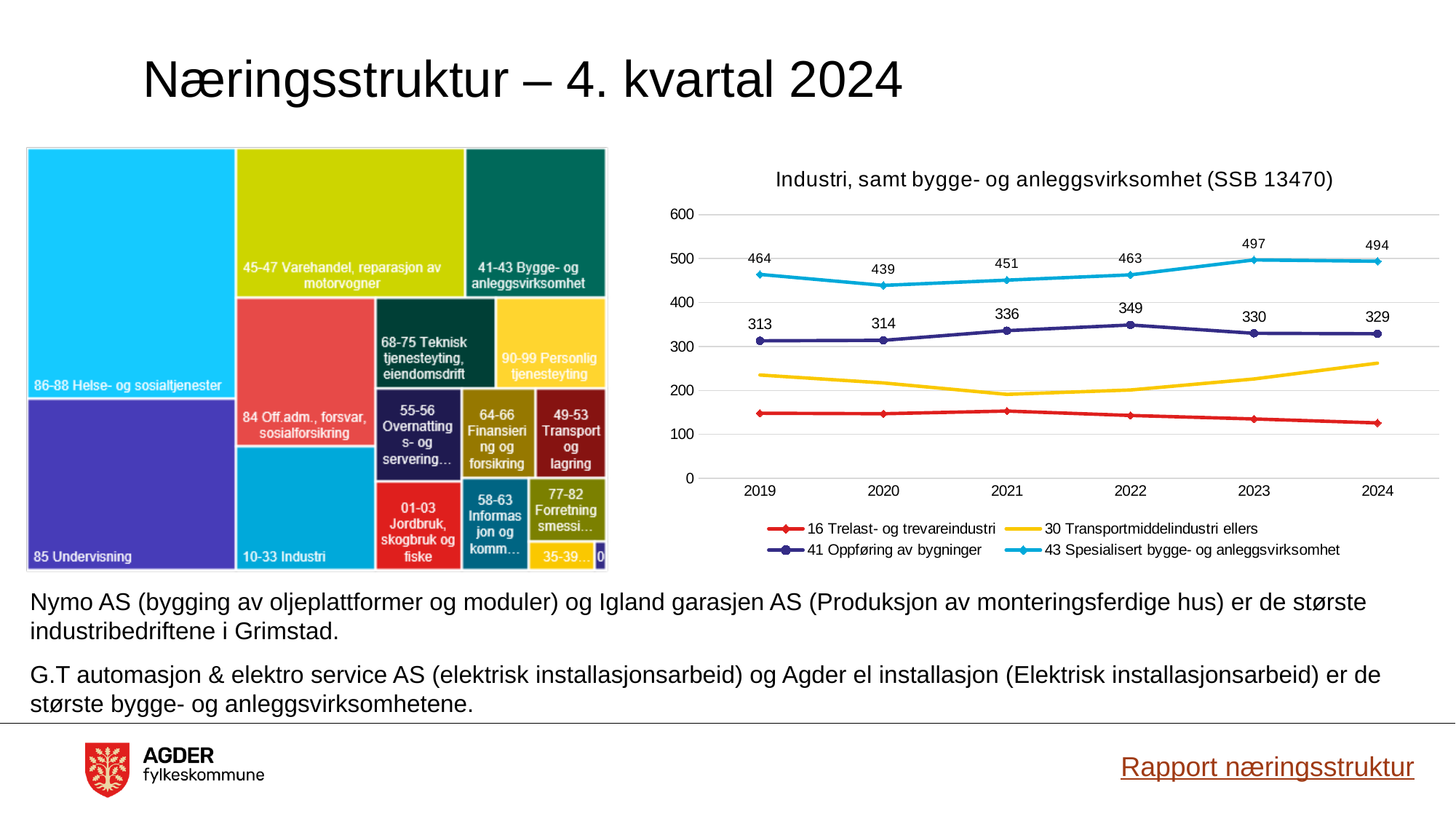
In the chart 'Industri, samt bygge- og anleggsvirksomhet (SSB 13470)', how many series does the legend list? 4 What kind of chart is 'Industri, samt bygge- og anleggsvirksomhet (SSB 13470)'? line chart In the chart 'Industri, samt bygge- og anleggsvirksomhet (SSB 13470)', by how much did '41 Oppføring av bygninger' increase from 2019 to 2022? 36 In the chart 'Industri, samt bygge- og anleggsvirksomhet (SSB 13470)', is the value for '30 Transportmiddelindustri ellers' in 2024 greater or less than 200? greater In the chart 'Industri, samt bygge- og anleggsvirksomhet (SSB 13470)', what is the value for '41 Oppføring av bygninger' in 2022? 349 In the chart 'Industri, samt bygge- og anleggsvirksomhet (SSB 13470)', does the value for '16 Trelast- og trevareindustri' rise or fall from 2021 to 2024? fall In the chart 'Industri, samt bygge- og anleggsvirksomhet (SSB 13470)', what is the difference between '43 Spesialisert bygge- og anleggsvirksomhet' and '41 Oppføring av bygninger' in 2024? 165 In the chart 'Industri, samt bygge- og anleggsvirksomhet (SSB 13470)', what is the value for '43 Spesialisert bygge- og anleggsvirksomhet' in 2023? 497 In the chart 'Industri, samt bygge- og anleggsvirksomhet (SSB 13470)', is the value for '41 Oppføring av bygninger' larger in 2021 or in 2023? 2021 In the chart 'Industri, samt bygge- og anleggsvirksomhet (SSB 13470)', in which year is '43 Spesialisert bygge- og anleggsvirksomhet' highest? 2023 In the chart 'Industri, samt bygge- og anleggsvirksomhet (SSB 13470)', is the value for '16 Trelast- og trevareindustri' in 2024 greater or less than 200? less In the chart 'Industri, samt bygge- og anleggsvirksomhet (SSB 13470)', in which year is '43 Spesialisert bygge- og anleggsvirksomhet' lowest? 2020